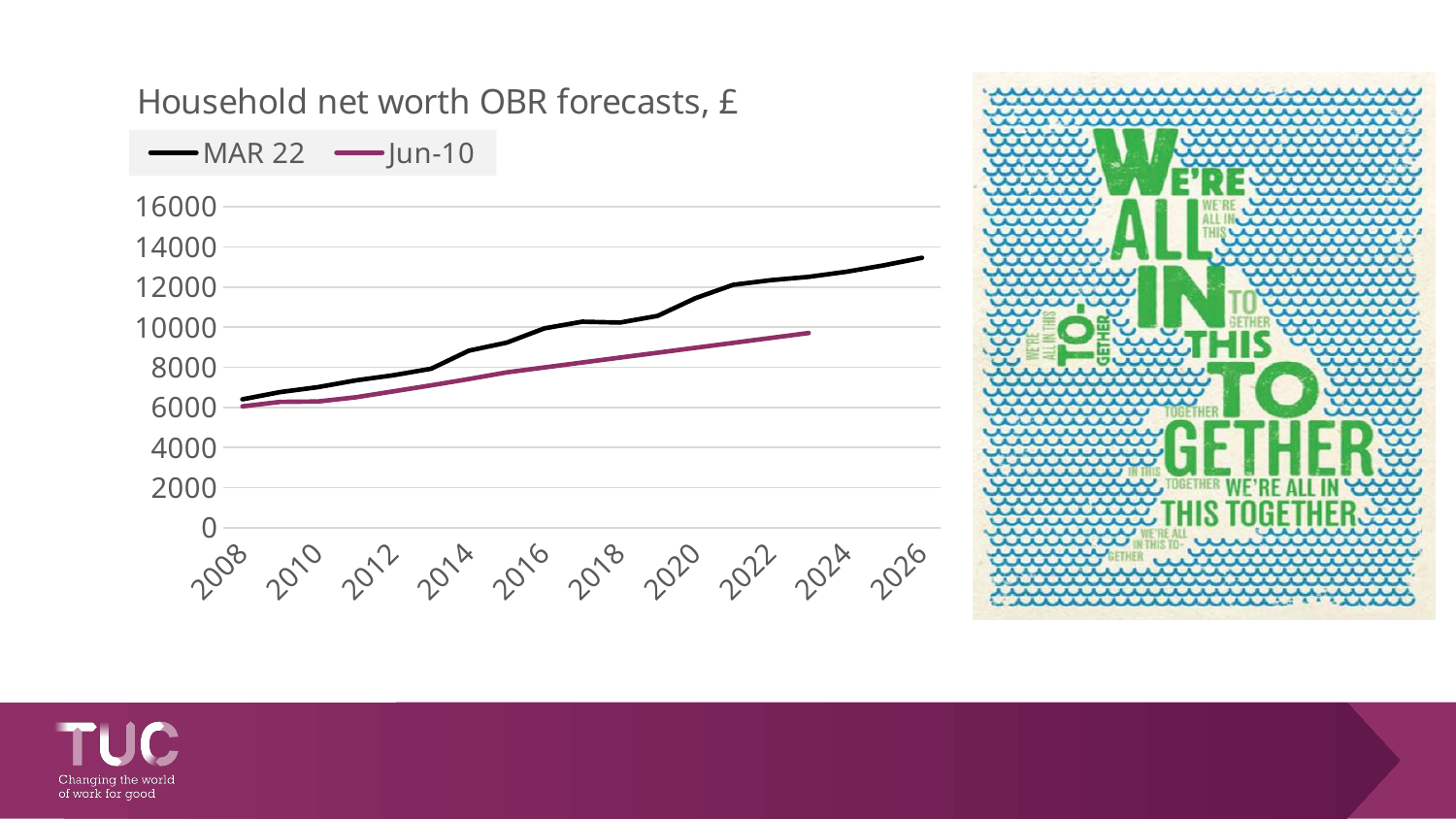
What kind of chart is shown on the slide? line chart Is the final value of the Jun-10 series greater or less than 10000? less Is the value for MAR 22 in 2026 greater or less than 12000? greater How many series does the legend list? 2 Does the MAR 22 series rise or fall from 2008 to 2026? rise Is the value for MAR 22 in 2016 greater or less than 8000? greater In 2020, which series has the higher value, MAR 22 or Jun-10? MAR 22 Which series is drawn in black? MAR 22 Does the Jun-10 series rise or fall along the x axis? rise Which series reaches the higher value at its end point? MAR 22 What is the title of the chart? Household net worth OBR forecasts, £ How many year labels are shown on the x axis? 10